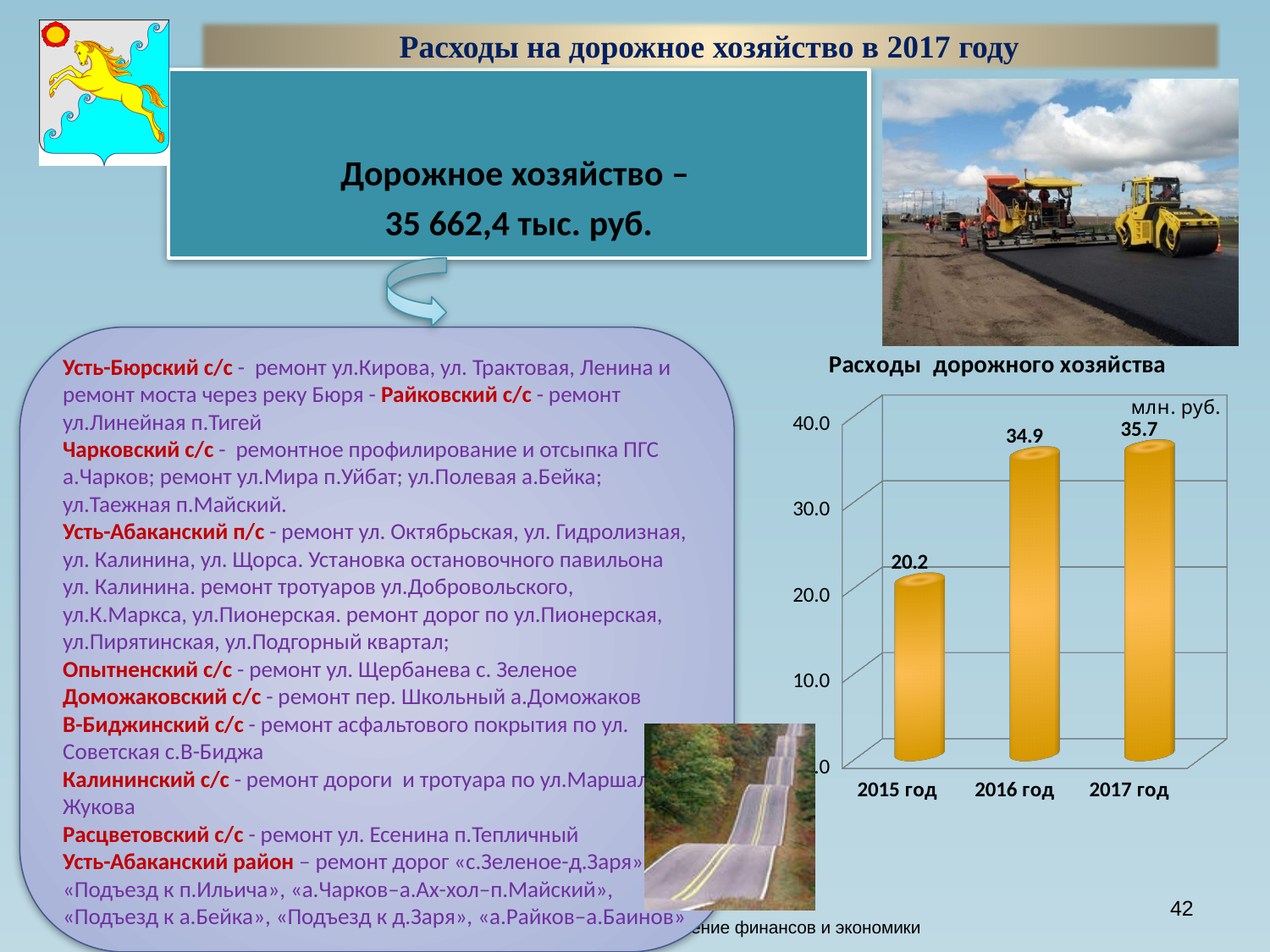
What is the title of the chart? Расходы дорожного хозяйства What is the value for 2016 год in the chart? 34.9 Which year has the lowest value in the chart? 2015 год What kind of chart is shown on the slide? bar chart What is the value for 2017 год in the chart? 35.7 What is the difference between the values for 2016 год and 2015 год? 14.7 Which is larger, the value for 2015 год or the value for 2016 год? 2016 год Is the value for 2015 год greater or less than 30.0? less What is the difference between the values for 2017 год and 2015 год? 15.5 What is the value for 2015 год in the chart? 20.2 How many years are shown in the chart? 3 Which year has the highest value in the chart? 2017 год